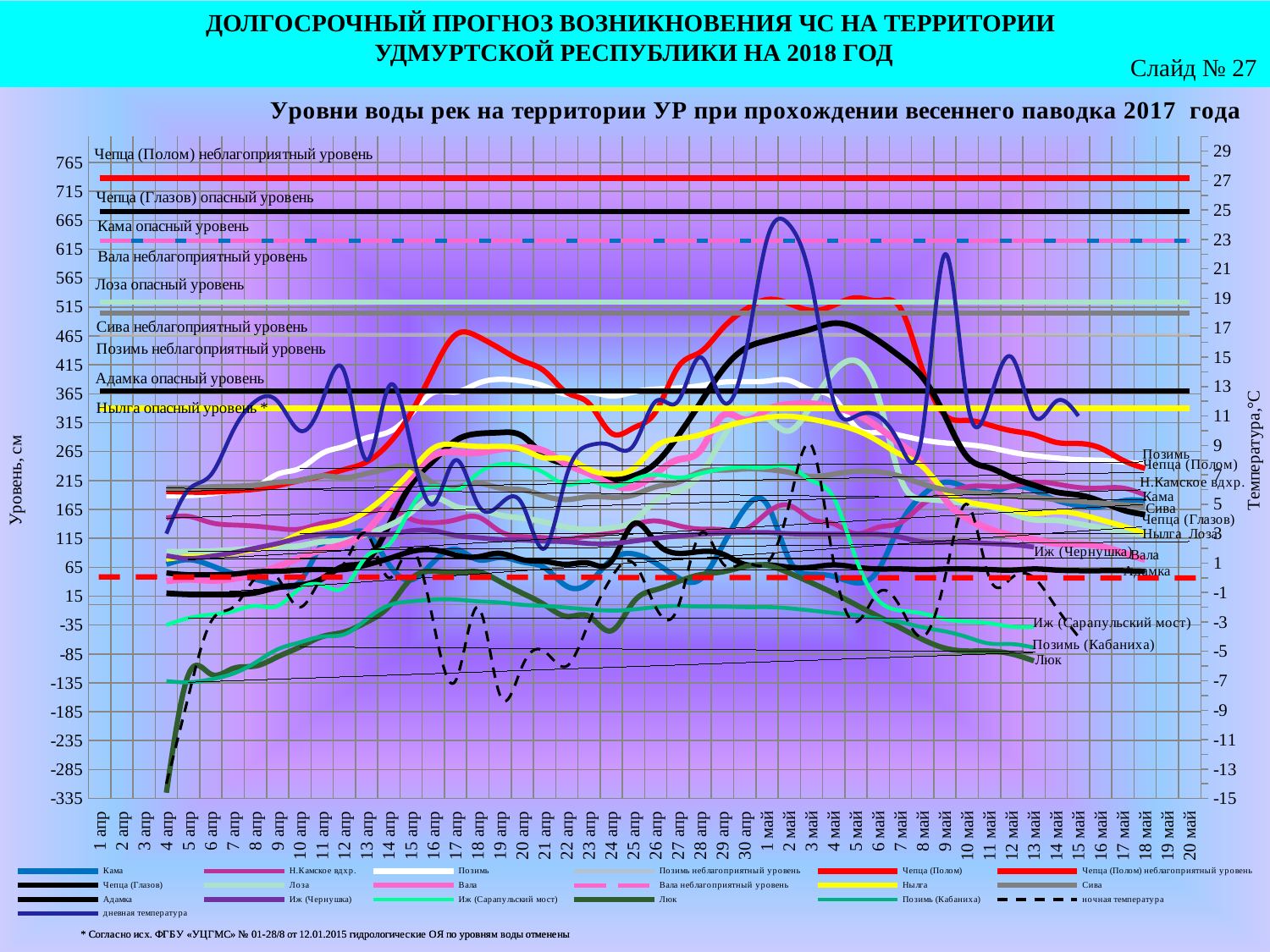
Is the horizontal line labelled 'Чепца (Полом) неблагоприятный уровень' greater or less than 715 on the left axis? greater How many series does the legend list? 19 What is the title of the chart? Уровни воды рек на территории УР при прохождении весеннего паводка 2017 года Is the horizontal line labelled 'Кама опасный уровень' greater or less than 665 on the left axis? less Does the Чепца (Полом) line rise or fall between 7 май and 18 май? fall How many dates are labelled along the x axis? 50 Which series starts at the lowest value on 4 апр? Люк What kind of chart is shown on the slide? line chart Which is higher on the chart: the 'Чепца (Полом) неблагоприятный уровень' line or the 'Чепца (Глазов) опасный уровень' line? Чепца (Полом) неблагоприятный уровень What is the label of the left vertical axis? Уровень, см Is the horizontal line labelled 'Адамка опасный уровень' greater or less than 415 on the left axis? less